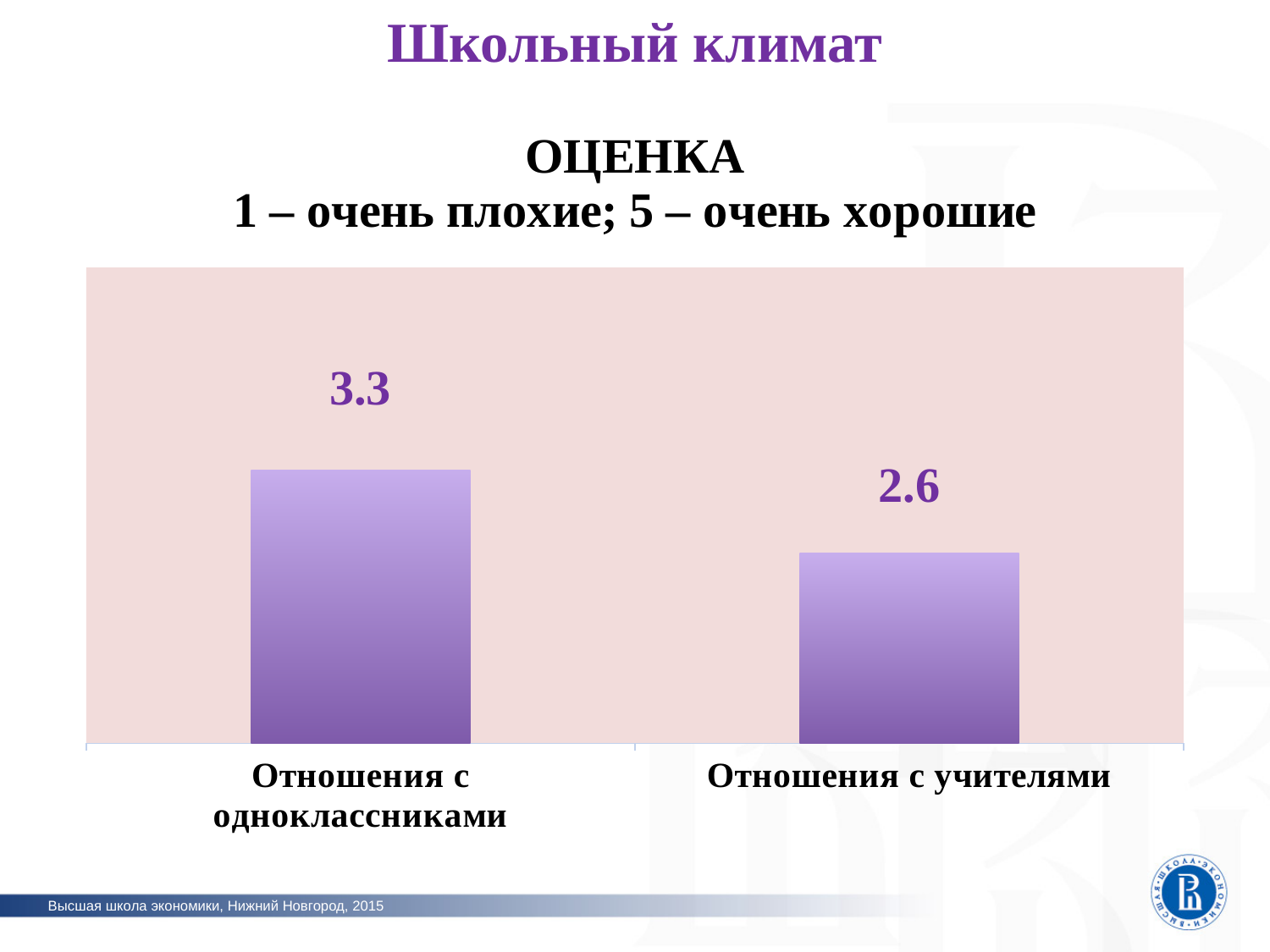
How many categories are shown in the chart? 2 Which category has the highest value? Отношения с одноклассниками What is the title of the slide? Школьный климат What is the value for "Отношения с учителями"? 2.6 Which is larger: the value for "Отношения с одноклассниками" or for "Отношения с учителями"? Отношения с одноклассниками What kind of chart is shown on the slide? Bar chart What is the difference between the values for "Отношения с одноклассниками" and "Отношения с учителями"? 0.7 According to the slide, what does a score of 5 mean on the rating scale? очень хорошие Do the values rise or fall from left to right across the categories? Fall What is the value for "Отношения с одноклассниками"? 3.3 Which category has the lowest value? Отношения с учителями